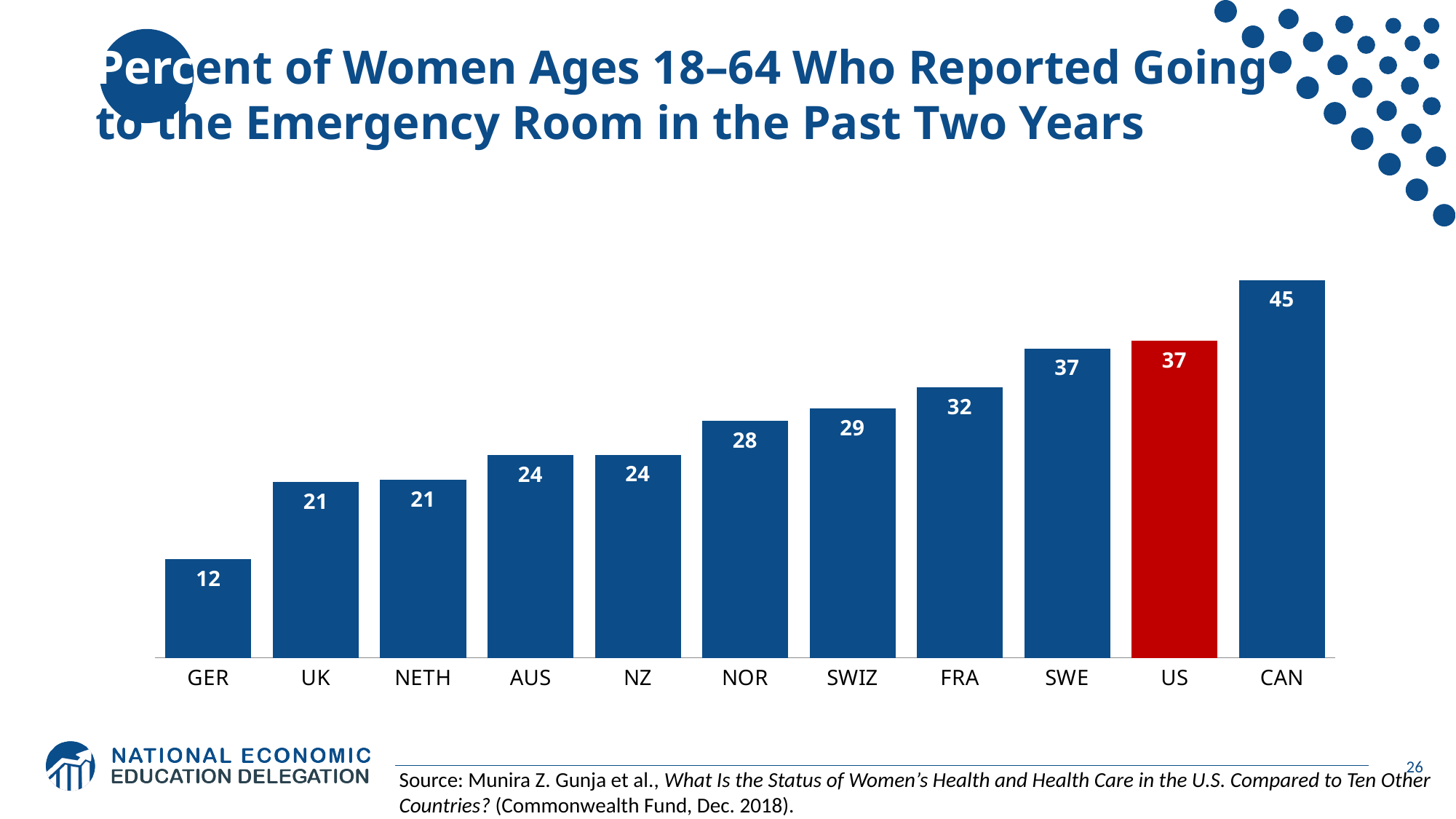
Do the values rise or fall from left to right across the chart? rise What is the value for the US? 37 What is the value for NOR? 28 What is the difference between the values for CAN and the US? 8 Which is larger, the value for SWIZ or the value for AUS? SWIZ What kind of chart is shown on the slide? bar chart Which country has the highest value? CAN How many countries are shown on the chart? 11 Which country has the lowest value? GER What is the value for GER? 12 Which bar is coloured red instead of blue? US What is the difference between the values for FRA and GER? 20